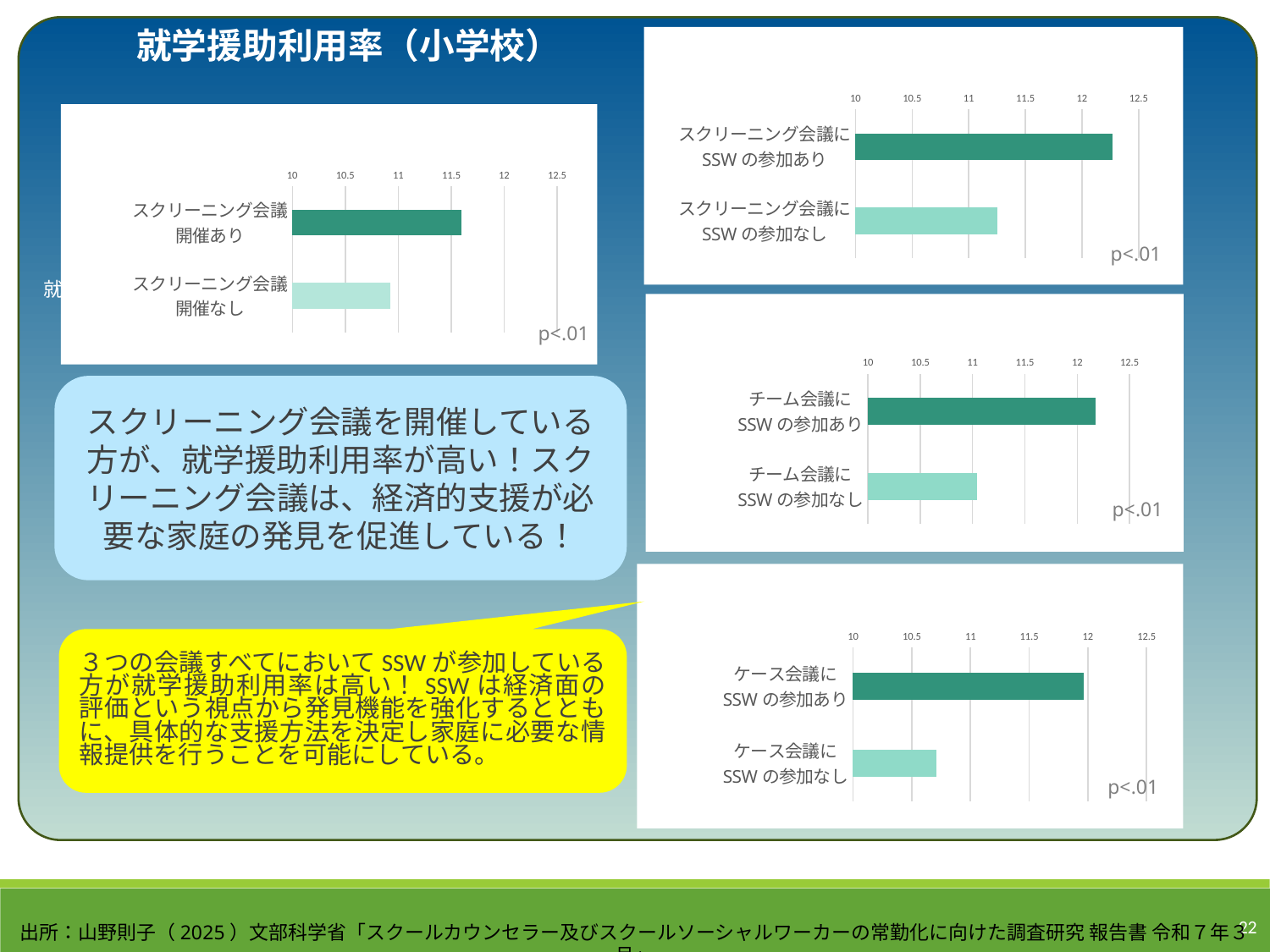
In the top-left chart, is the value for スクリーニング会議開催あり greater or less than 11? greater In the top-right chart (スクリーニング会議にSSWの参加あり/なし), is the value for SSWの参加あり greater or less than 12? greater In the bottom-right chart (ケース会議), is the value for ケース会議にSSWの参加あり greater or less than 11.5? greater How many categories are plotted in the top-right chart (スクリーニング会議にSSWの参加)? 2 In the bottom-right chart (ケース会議), which category has the smaller value? ケース会議にSSWの参加なし What kind of chart is the top-left chart? Bar chart In the top-left chart (スクリーニング会議 開催あり/開催なし), which category has the larger value? スクリーニング会議開催あり In the middle-right chart (チーム会議), which category has the larger value? チーム会議にSSWの参加あり